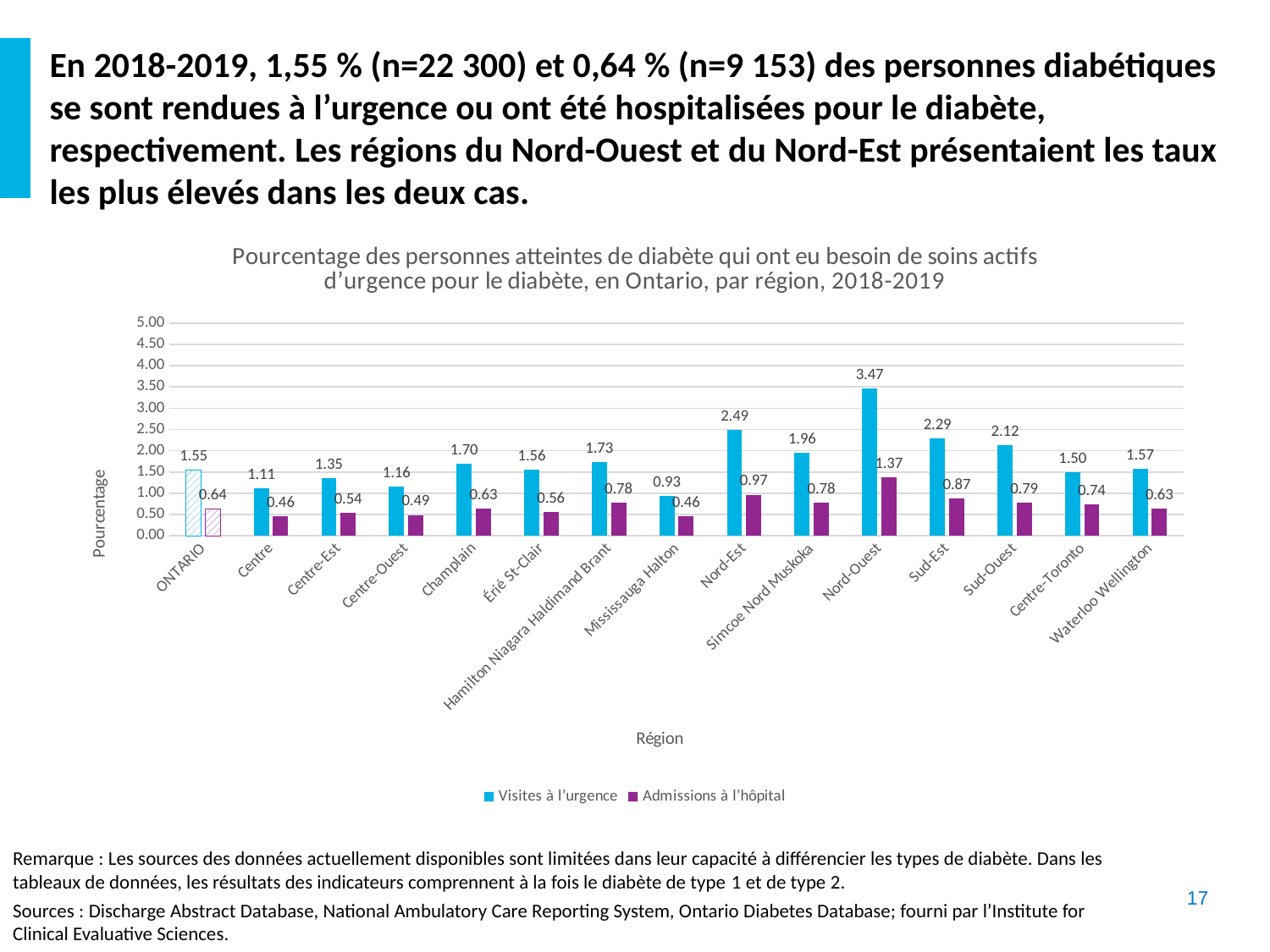
Which region has the lowest value for Visites à l'urgence? Mississauga Halton What is the value for Admissions à l'hôpital in Nord-Est? 0.97 How many series does the legend list? 2 What is the value for Visites à l'urgence in Nord-Ouest? 3.47 What is the difference between Visites à l'urgence and Admissions à l'hôpital for Nord-Ouest? 2.10 What is the value for Visites à l'urgence in Champlain? 1.70 What is the label of the y axis? Pourcentage Which region has the highest value for Visites à l'urgence? Nord-Ouest How many regions (categories) are shown on the x axis? 15 Is the value for Visites à l'urgence in Nord-Est greater or less than 2.00? greater Which is larger, Visites à l'urgence for Sud-Est or for Sud-Ouest? Sud-Est What kind of chart is shown on the slide? Bar chart